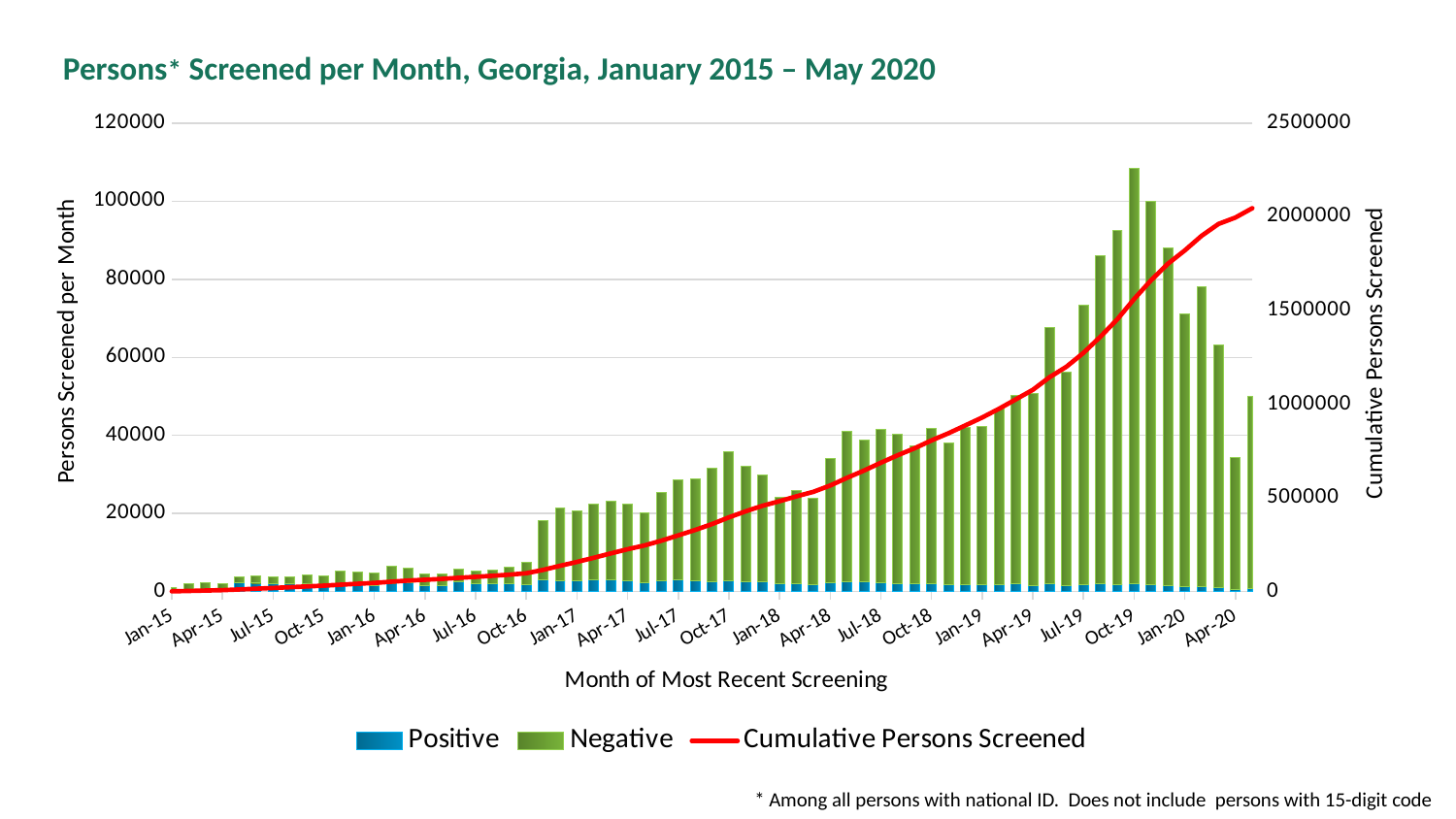
Which month has more persons screened, Apr-20 or May-20? May-20 Which month has the highest number of persons screened? Oct-19 How many series does the legend list? 3 Is the number of persons screened in Apr-20 greater or less than 40000? less Is the number of persons screened in Oct-19 greater or less than 100000? greater What is the title of the chart? Persons* Screened per Month, Georgia, January 2015 – May 2020 Is the number of persons screened in Jan-15 greater or less than 20000? less Does the Cumulative Persons Screened line rise or fall from Jan-15 to May-20? rise What kind of chart is shown on the slide? Bar chart with a line What are the three series listed in the legend? Positive, Negative, Cumulative Persons Screened